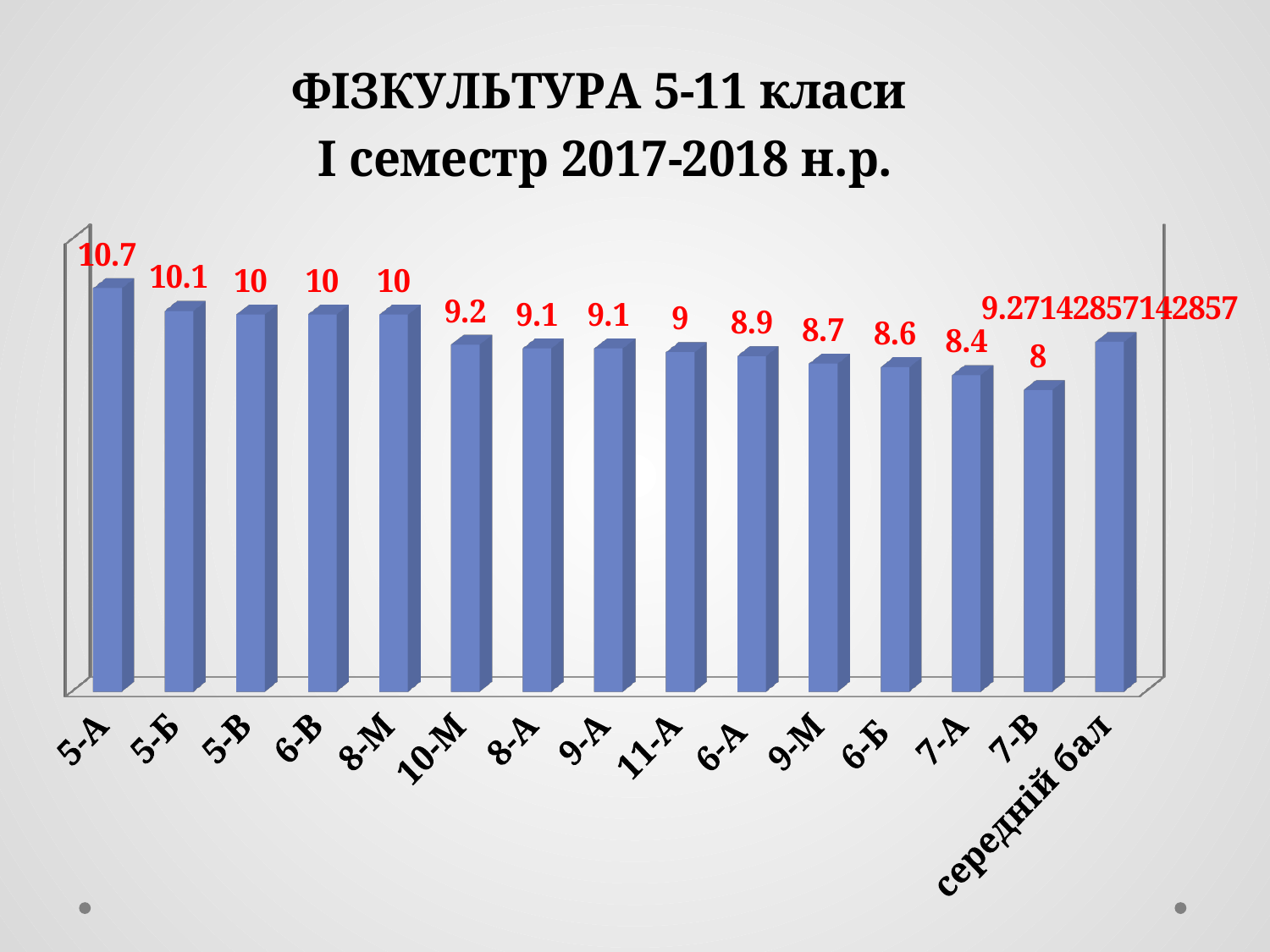
How many categories are shown on the x axis? 15 What is the difference between the values for 5-А and 7-В? 2.7 What is the value for 5-А? 10.7 What is the title of the chart? ФІЗКУЛЬТУРА 5-11 класи І семестр 2017-2018 н.р. What is the difference between the values for 5-Б and 6-Б? 1.5 What is the value shown for середній бал? 9.27142857142857 Which category has the highest value? 5-А Which is larger, the value for 9-М or the value for 7-А? 9-М Which category has the lowest value? 7-В What is the value for 7-В? 8 What is the value for 10-М? 9.2 What kind of chart is shown on the slide? bar chart